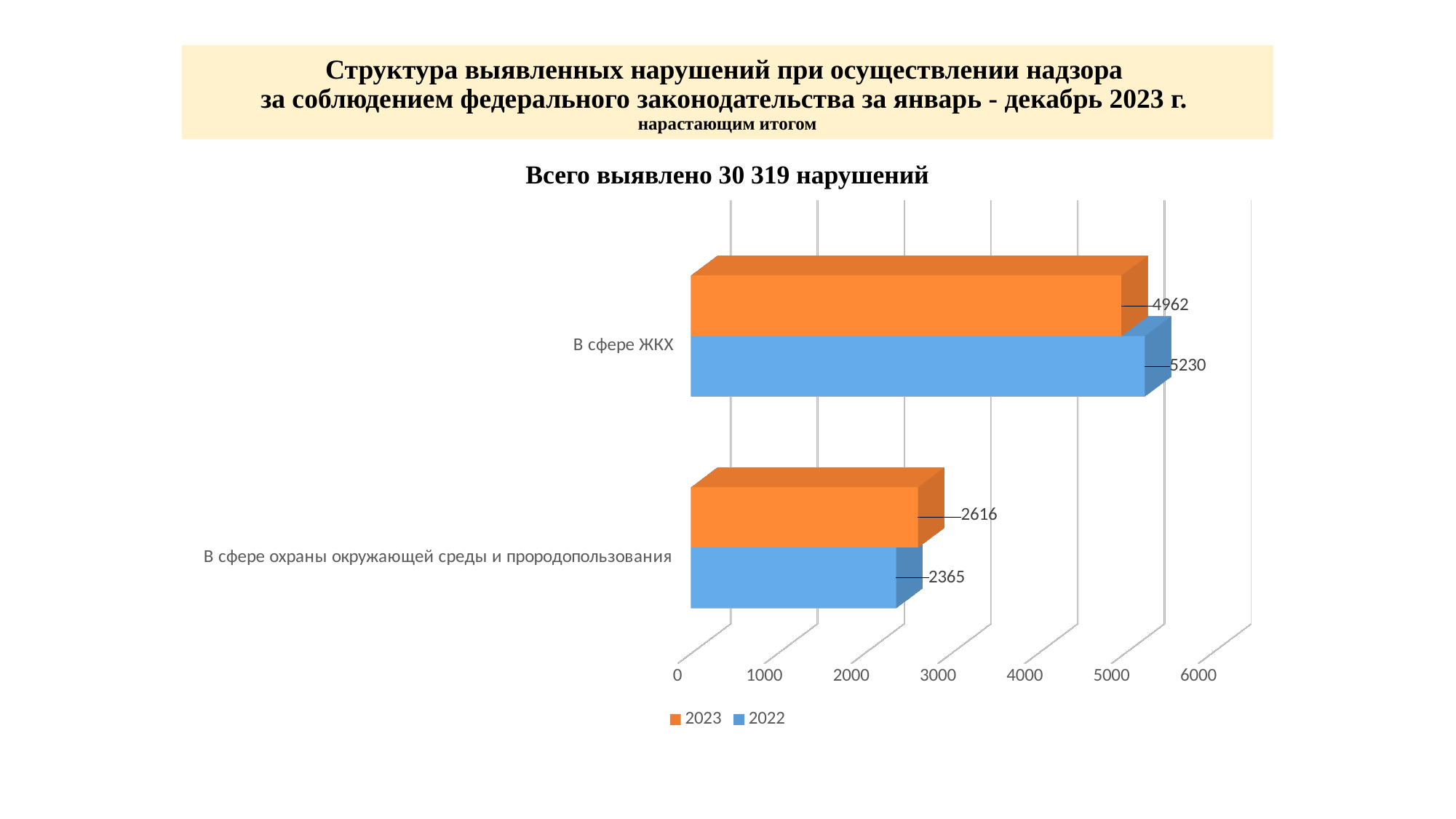
What is the value for 2023 in the category 'В сфере охраны окружающей среды и прородопользования'? 2616 What is the value for 2023 in the category 'В сфере ЖКХ'? 4962 For 'В сфере ЖКХ', which series has the larger value, 2023 or 2022? 2022 Which category has the highest value for the 2022 series? В сфере ЖКХ What is the value for 2022 in the category 'В сфере охраны окружающей среды и прородопользования'? 2365 What is the difference between the 2023 and 2022 values for 'В сфере охраны окружающей среды и прородопользования'? 251 What kind of chart is shown on the slide? Bar chart What is the value for 2022 in the category 'В сфере ЖКХ'? 5230 What is the difference between the 2022 and 2023 values for 'В сфере ЖКХ'? 268 How many categories are shown on the chart? 2 Which category has the lowest value for the 2023 series? В сфере охраны окружающей среды и прородопользования How many series does the legend list? 2